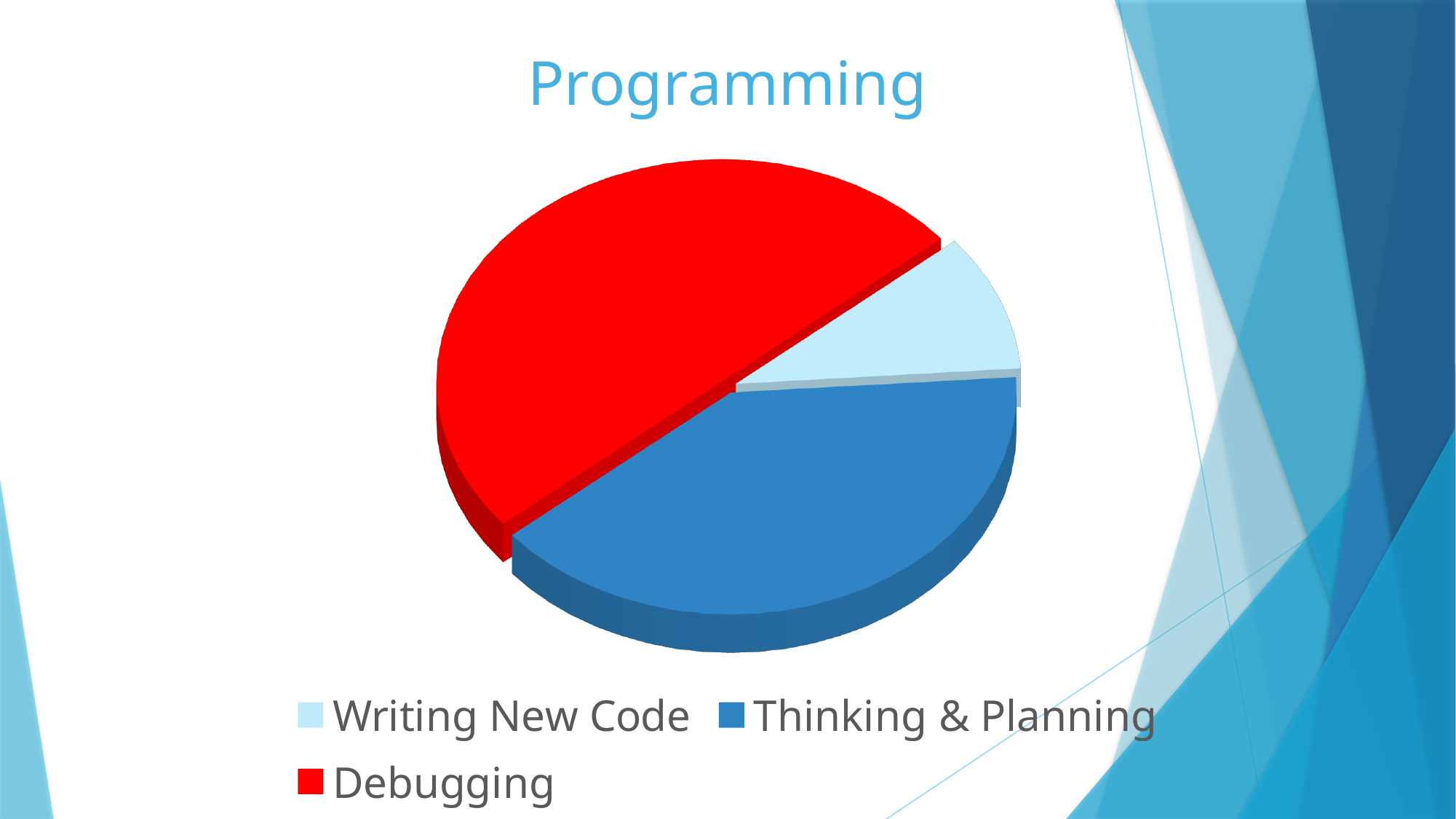
What kind of chart is shown on the slide? Pie chart How many slices does the pie chart have? 3 What colour is the Debugging slice? Red Which slice is larger, Debugging or Thinking & Planning? Debugging Which slice is smaller, Writing New Code or Debugging? Writing New Code Which slice is larger, Thinking & Planning or Writing New Code? Thinking & Planning What is the title of the chart? Programming Which category has the largest slice of the pie? Debugging How many entries does the legend list? 3 Which category has the smallest slice of the pie? Writing New Code